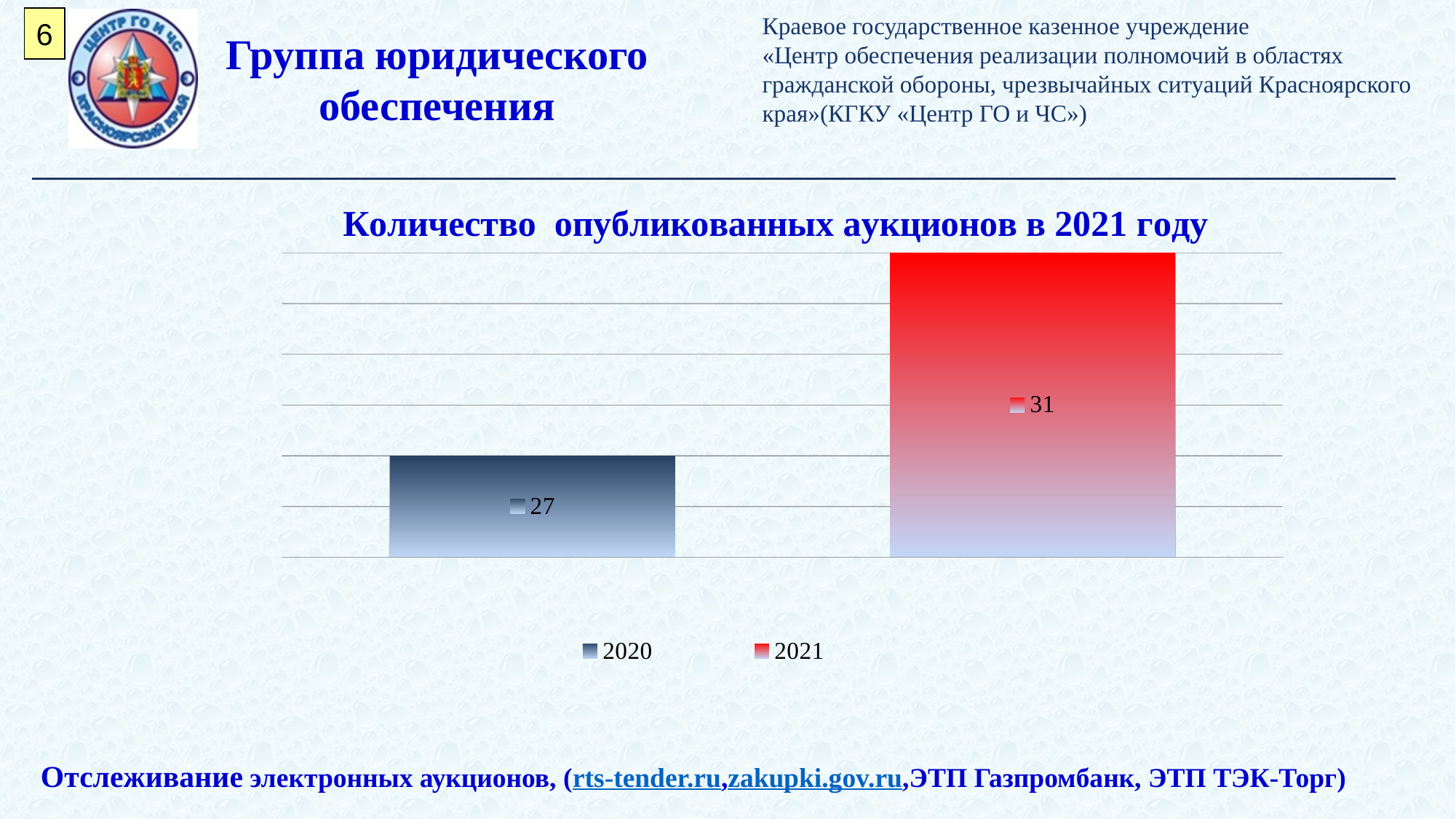
Do the values rise or fall from 2020 to 2021? rise What is the value for 2020 in the chart? 27 Which year has the lower value in the chart? 2020 What kind of chart is shown on the slide? bar chart Is the value for 2021 larger or smaller than the value for 2020? larger What is the title of the chart? Количество опубликованных аукционов в 2021 году What colour is the bar for 2021? red How many series does the legend list? 2 What is the difference between the values for 2021 and 2020? 4 How many bars are plotted in the chart? 2 What is the value for 2021 in the chart? 31 Which year has the higher value in the chart? 2021